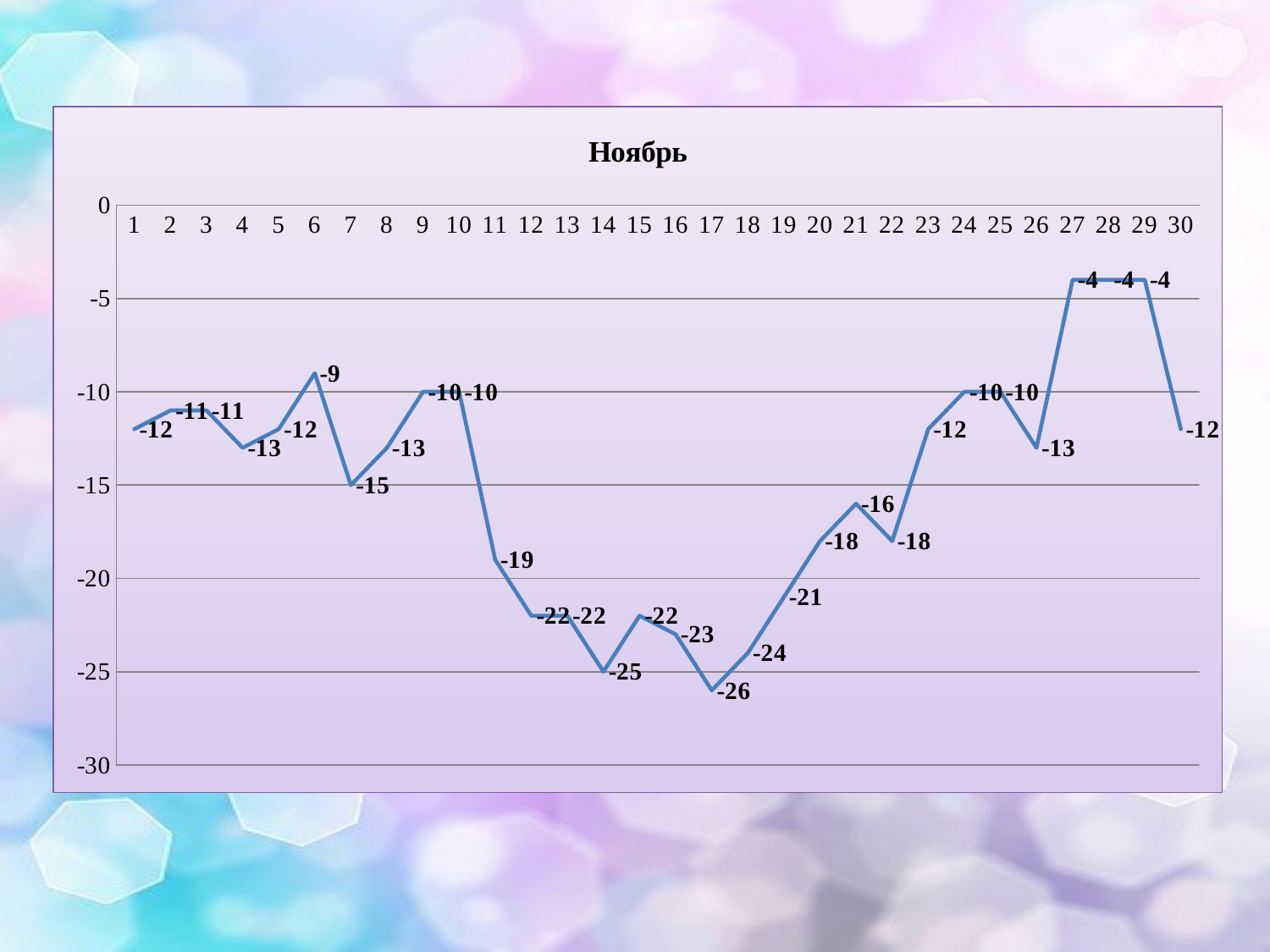
What is the difference between the values for day 14 and day 11? 6 What is the highest value shown on the chart? -4 What is the difference between the values for day 27 and day 30? 8 What is the value for day 30? -12 Which is larger, the value for day 7 or the value for day 9? day 9 What kind of chart is shown on the slide? line chart What is the title of the chart? Ноябрь How many days (data points) are plotted on the chart? 30 Do the values rise or fall from day 10 to day 17? fall On which day is the lowest value recorded? 17 What is the value for day 6? -9 What is the value for day 17? -26